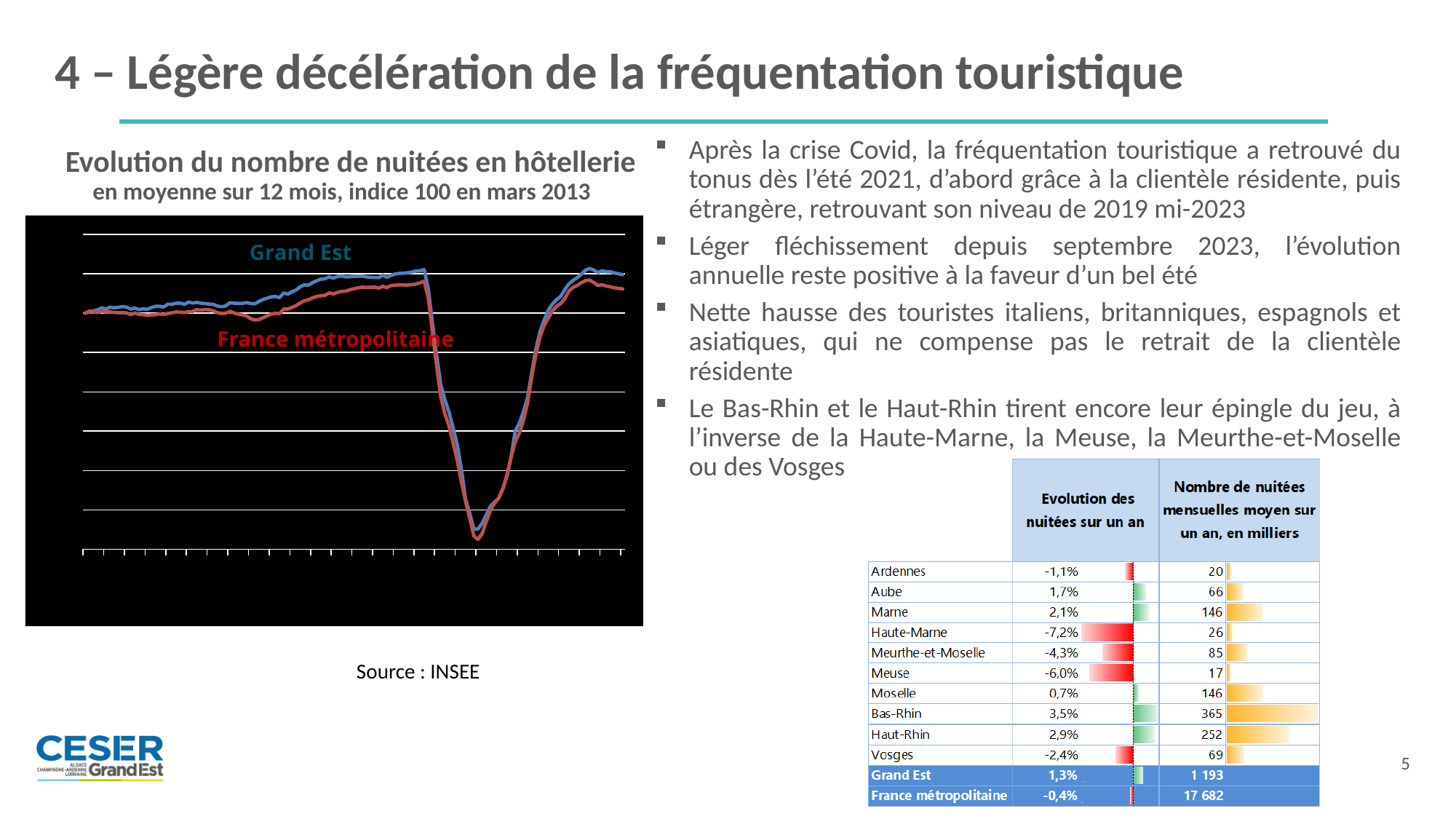
How many departments are listed in the table on the right (excluding the Grand Est and France métropolitaine rows)? 10 What kind of chart is the chart on the left titled 'Evolution du nombre de nuitées en hôtellerie'? line chart In the table on the right, what is the difference in monthly nuitées (en milliers) between Bas-Rhin and Haut-Rhin? 113 In the table on the right, which department has the lowest 'Evolution des nuitées sur un an'? Haute-Marne How many series are plotted in the line chart on the left? 2 In the table on the right, which department has the highest number of monthly nuitées? Bas-Rhin In the table on the right, what is the 'Evolution des nuitées sur un an' for Grand Est? 1,3% In the table on the right, what is the 'Evolution des nuitées sur un an' for Bas-Rhin? 3,5% In the table on the right, what is the 'Nombre de nuitées mensuelles moyen sur un an, en milliers' for France métropolitaine? 17 682 In the table on the right, which has the higher 'Evolution des nuitées sur un an', Ardennes or Meuse? Ardennes In the line chart on the left, which series is drawn in red? France métropolitaine In the table on the right, what is the 'Nombre de nuitées mensuelles moyen sur un an, en milliers' for Haut-Rhin? 252